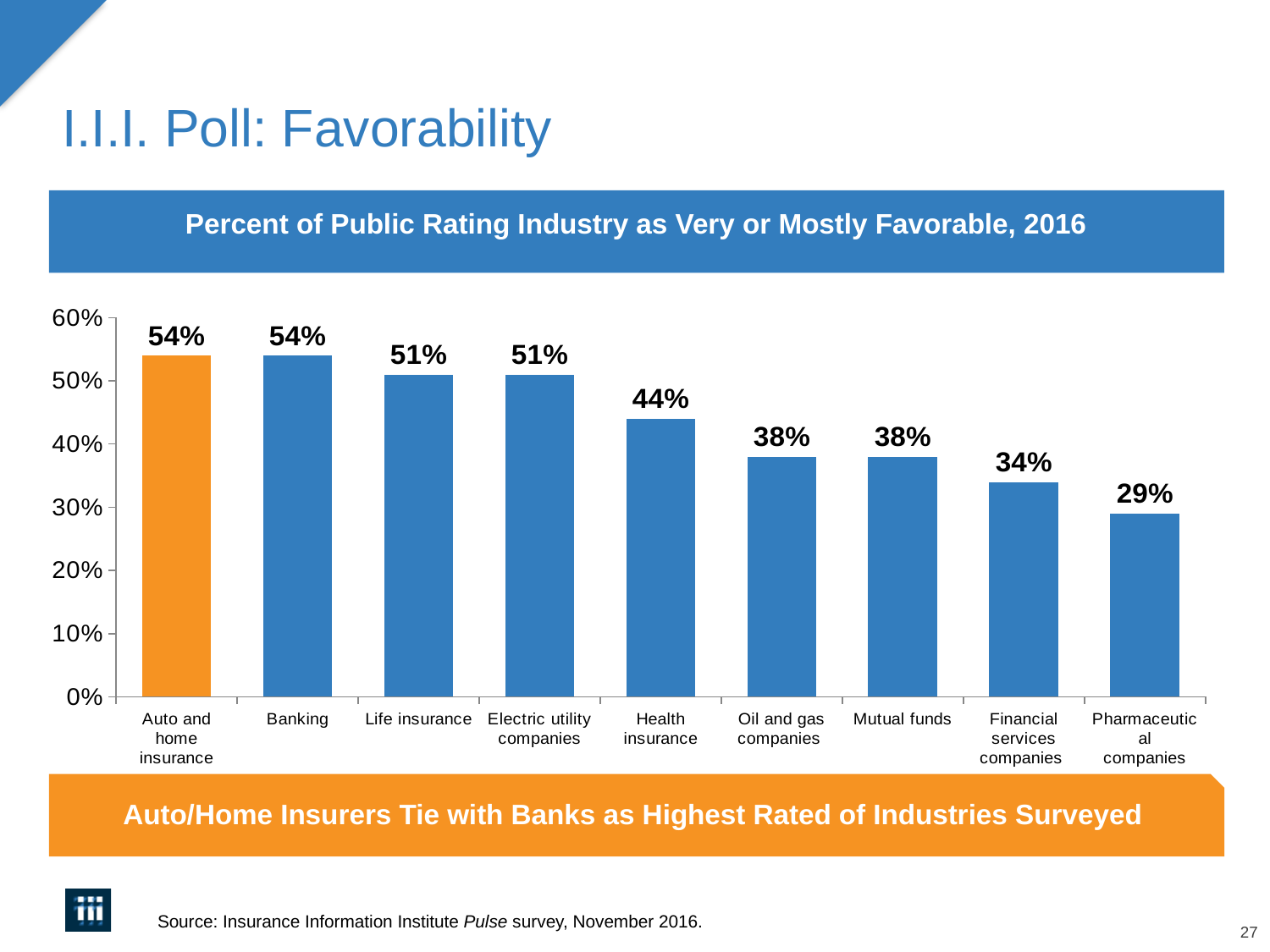
Which category has the lowest favorability rating? Pharmaceutical companies What kind of chart is shown on the slide? Bar chart Which bar is colored orange rather than blue? Auto and home insurance What is the value shown for financial services companies? 34% What is the difference between the favorability rating for banking and for pharmaceutical companies? 25% Which has a higher favorability rating, mutual funds or financial services companies? Mutual funds Which two categories tie for the highest favorability rating? Auto and home insurance and Banking What is the value shown for pharmaceutical companies? 29% How many industries are shown in the chart? 9 What is the difference between the values for life insurance and health insurance? 7% Do the values generally rise or fall from left to right across the chart? Fall What percent of the public rated health insurance as very or mostly favorable? 44%